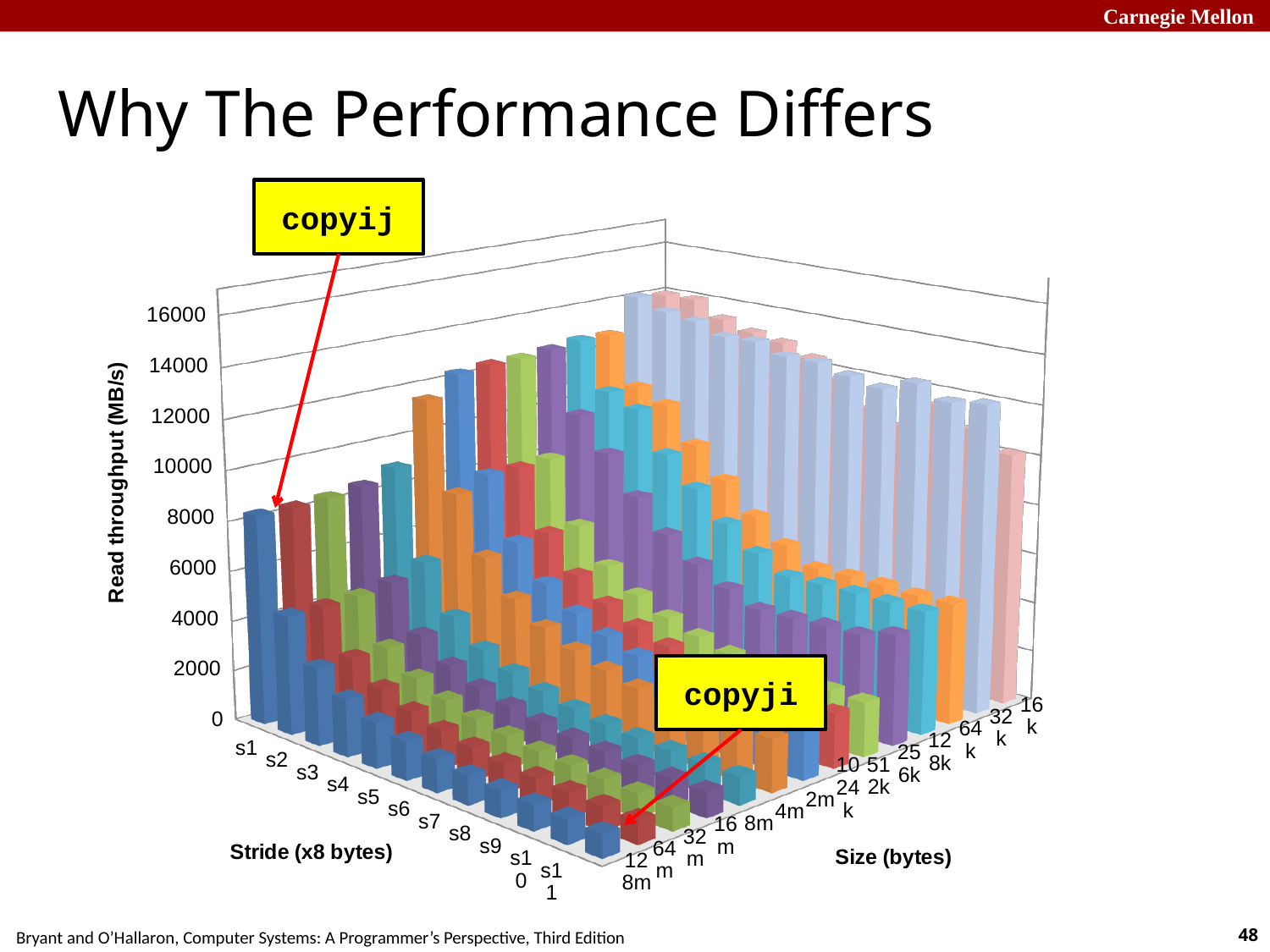
What is the title of the vertical axis? Read throughput (MB/s) How many stride categories (s1 through s11) are shown along the Stride axis? 11 What two function names are shown in the yellow callout boxes on the chart? copyij and copyji What kind of chart is shown on the slide? 3D bar chart For the 128m size, does read throughput rise or fall as stride increases from s1 to s11? fall How many size categories are shown along the Size (bytes) axis? 14 Is the read throughput for stride s1 at size 128m greater or less than 4000? greater Is the read throughput for stride s11 at size 128m greater or less than 4000? less Which stride has the higher read throughput at size 128m, s1 or s11? s1 Is the read throughput for stride s1 at size 128m greater or less than 12000? less